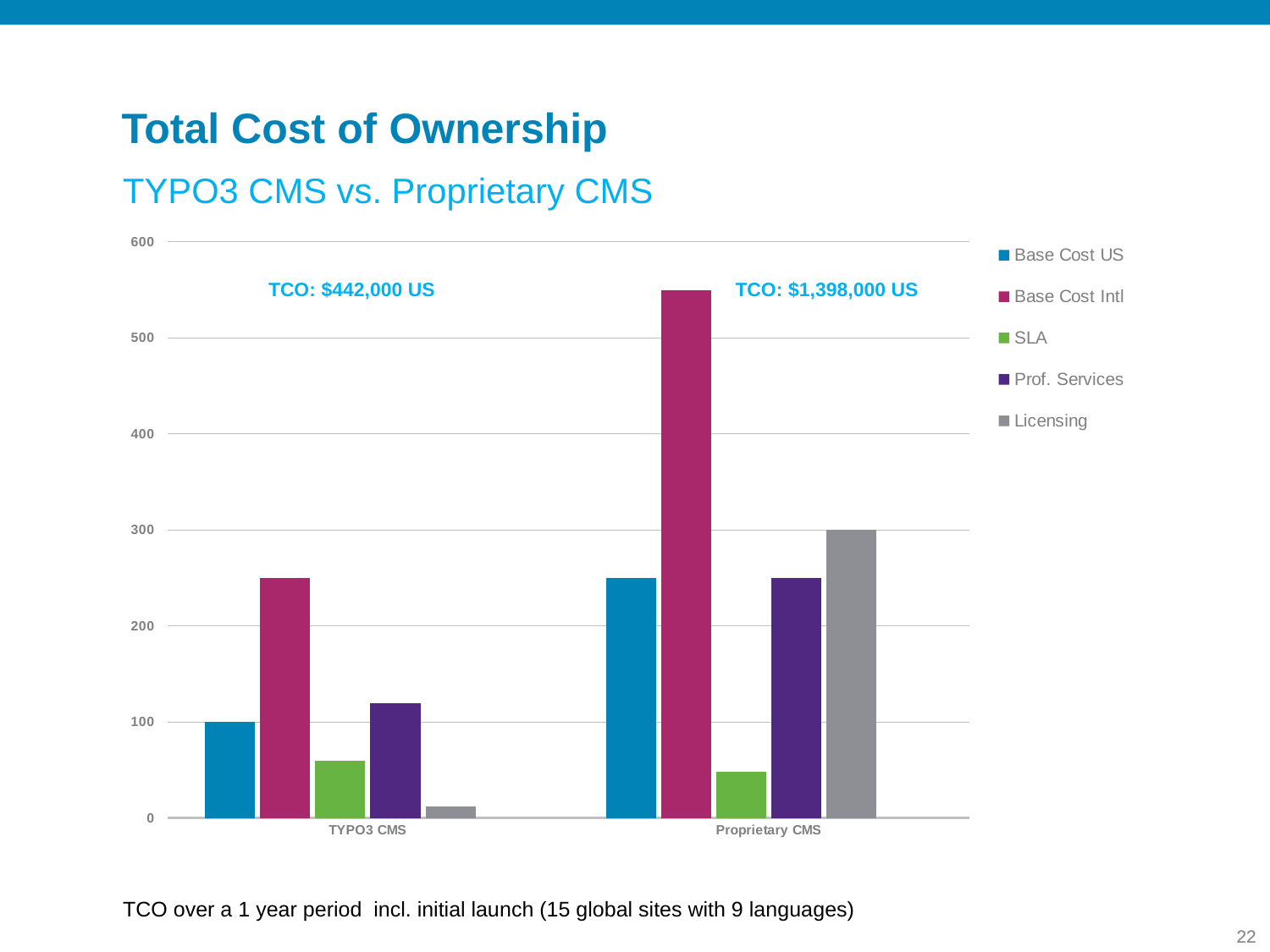
Is the SLA value for TYPO3 CMS greater or less than 100? less What TCO value is printed above the Proprietary CMS group? TCO: $1,398,000 US Which series has the lowest bar for TYPO3 CMS? Licensing Which is larger for Proprietary CMS: Base Cost US or SLA? Base Cost US What is the subtitle of the chart shown on the slide? TYPO3 CMS vs. Proprietary CMS How many categories are shown on the x axis? 2 What TCO value is printed above the TYPO3 CMS group? TCO: $442,000 US Which is larger: the Licensing bar for TYPO3 CMS or the Licensing bar for Proprietary CMS? Proprietary CMS What type of chart is shown on the slide? Bar chart Is the Base Cost Intl value for Proprietary CMS greater or less than 500? greater Which series has the highest bar for Proprietary CMS? Base Cost Intl How many series does the legend list? 5